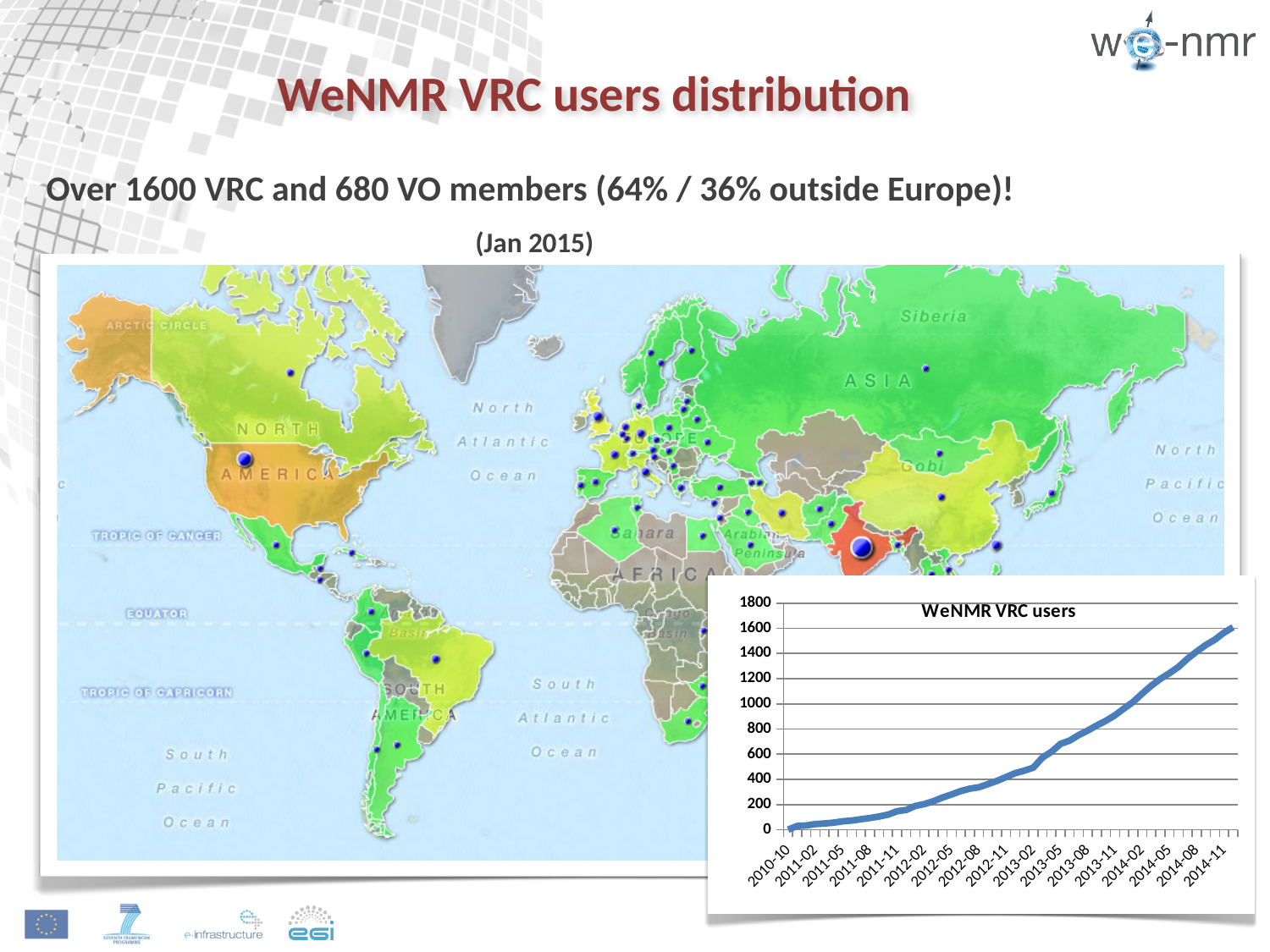
What kind of chart is the WeNMR VRC users chart? line chart In the WeNMR VRC users chart, which date has the lowest value? 2010-10 What is the highest value shown on the y axis of the WeNMR VRC users chart? 1800 What is the title of the chart in the lower right of the slide? WeNMR VRC users How many date labels are shown on the x axis of the WeNMR VRC users chart? 17 In the WeNMR VRC users chart, is the value at 2014-11 greater or less than 1400? greater In the WeNMR VRC users chart, is the value at 2012-05 greater or less than 400? less In the WeNMR VRC users chart, is the value at 2013-05 greater or less than 400? greater In the WeNMR VRC users chart, which is larger: the value at 2012-08 or the value at 2013-08? 2013-08 Do the values in the WeNMR VRC users chart rise or fall from 2010-10 to 2014-11? rise